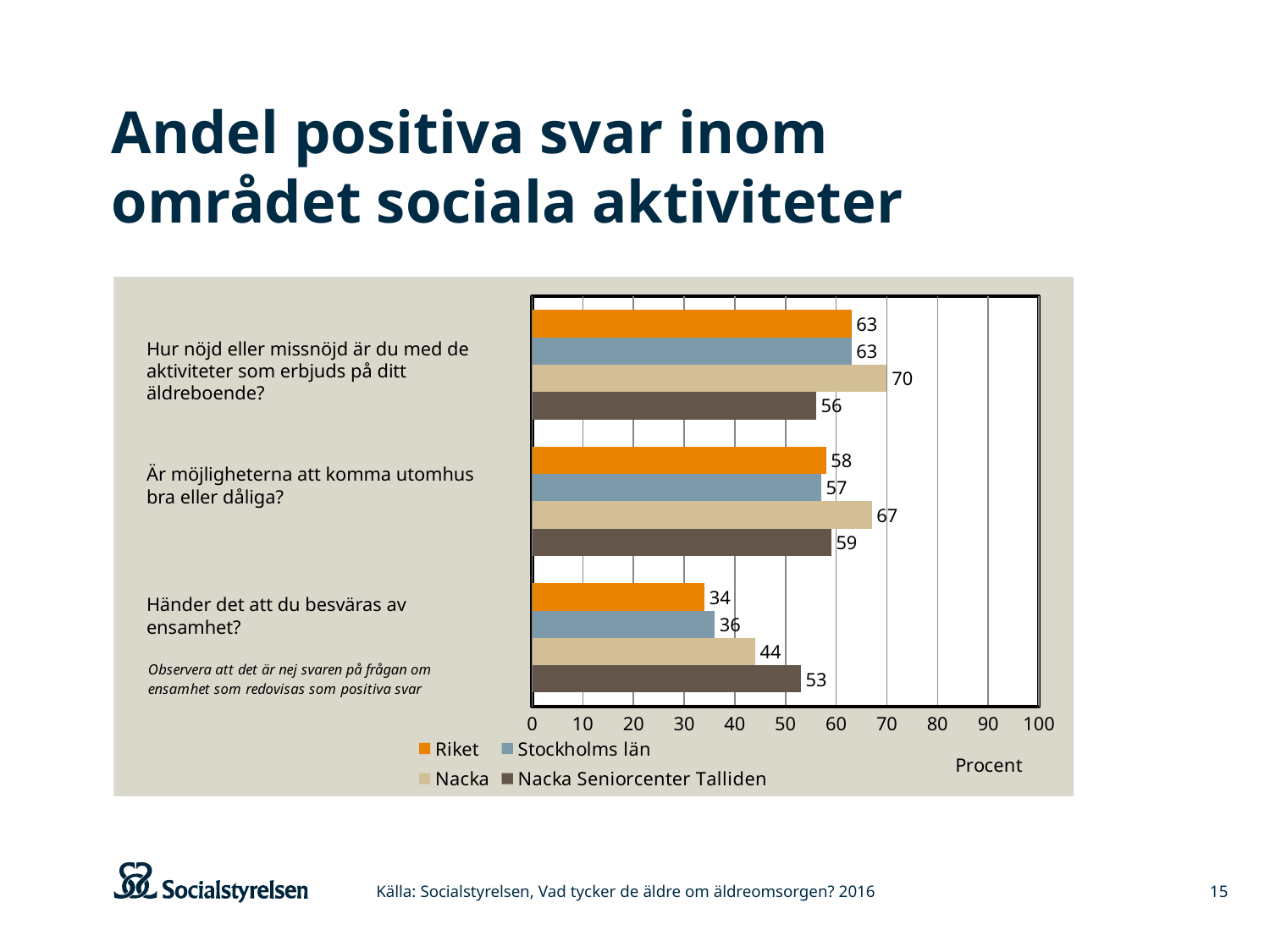
What is the label of the x axis? Procent What kind of chart is shown on the slide? Bar chart Which series has the lowest value on the question "Händer det att du besväras av ensamhet?"? Riket What is the value for Stockholms län on the question "Är möjligheterna att komma utomhus bra eller dåliga?"? 57 How many series does the legend list? 4 What is the value for Nacka Seniorcenter Talliden on the question "Händer det att du besväras av ensamhet?"? 53 Which is larger on the question "Händer det att du besväras av ensamhet?": Nacka or Nacka Seniorcenter Talliden? Nacka Seniorcenter Talliden Which series is shown in orange in the legend? Riket Which series has the highest value on the question "Är möjligheterna att komma utomhus bra eller dåliga?"? Nacka How many question categories are plotted on the chart? 3 What is the value for Nacka on the question "Hur nöjd eller missnöjd är du med de aktiviteter som erbjuds på ditt äldreboende?"? 70 What is the difference between Nacka and Nacka Seniorcenter Talliden on the question "Hur nöjd eller missnöjd är du med de aktiviteter som erbjuds på ditt äldreboende?"? 14